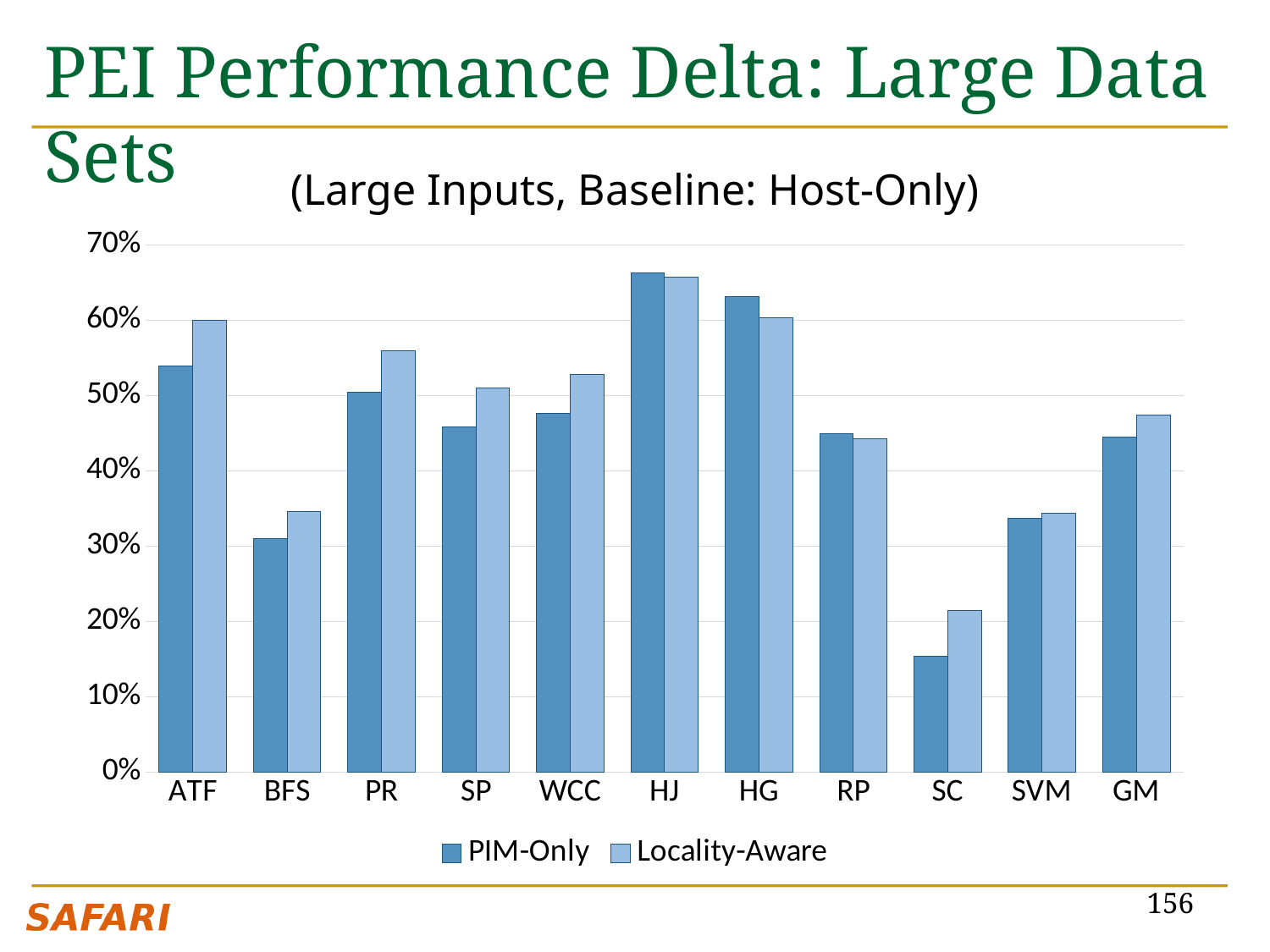
What kind of chart is shown on the slide? bar chart Is the PIM-Only value for SC greater or less than 20%? less What are the two series named in the legend? PIM-Only and Locality-Aware Which category has the highest PIM-Only value? HJ Is the PIM-Only value for ATF greater or less than 50%? greater Which category has the lowest Locality-Aware value? SC How many series does the legend list? 2 For HG, which is larger: the PIM-Only value or the Locality-Aware value? PIM-Only Is the Locality-Aware value for BFS greater or less than 40%? less Which category has the lowest PIM-Only value? SC For PR, which is larger: the PIM-Only value or the Locality-Aware value? Locality-Aware How many categories are shown on the x axis? 11